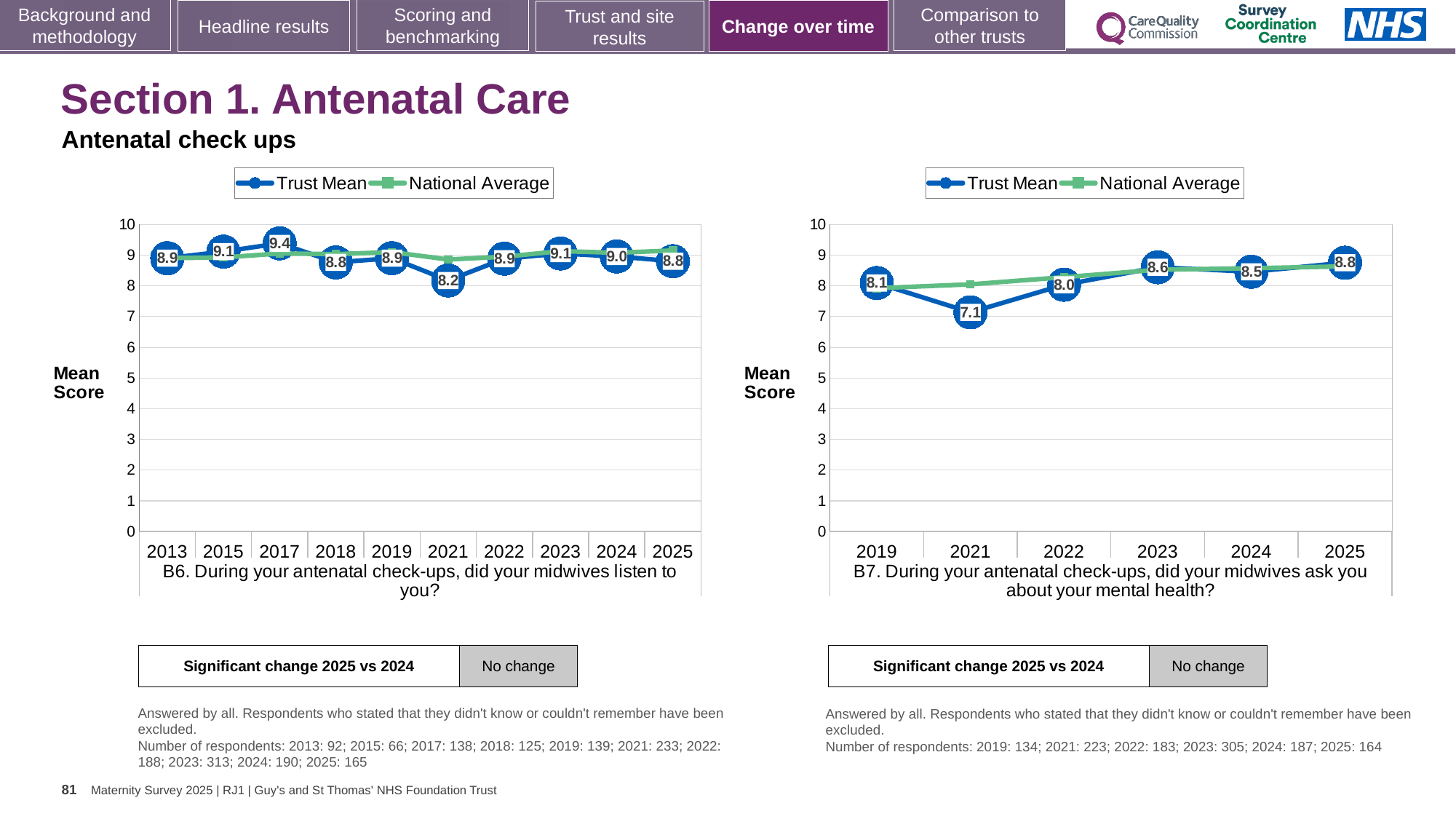
In the B6 chart (left), which year has the highest Trust Mean? 2017 In the B7 chart (right), what is the difference between the Trust Mean for 2025 and the Trust Mean for 2021? 1.7 In the B7 chart (right), is the Trust Mean for 2019 or for 2023 larger? 2023 In the B6 chart (left), how many years are plotted on the x axis? 10 In the B6 chart (left), what is the Trust Mean for 2017? 9.4 In the B7 chart (right), which year has the lowest Trust Mean? 2021 In the B7 chart (right), what is the Trust Mean for 2025? 8.8 What kind of chart is the B6 chart (left)? Line chart How many series does the legend of the B7 chart (right) list? 2 In the B7 chart (right), what is the Trust Mean for 2021? 7.1 In the B6 chart (left), which year has the lowest Trust Mean? 2021 In the B6 chart (left), what is the Trust Mean for 2021? 8.2